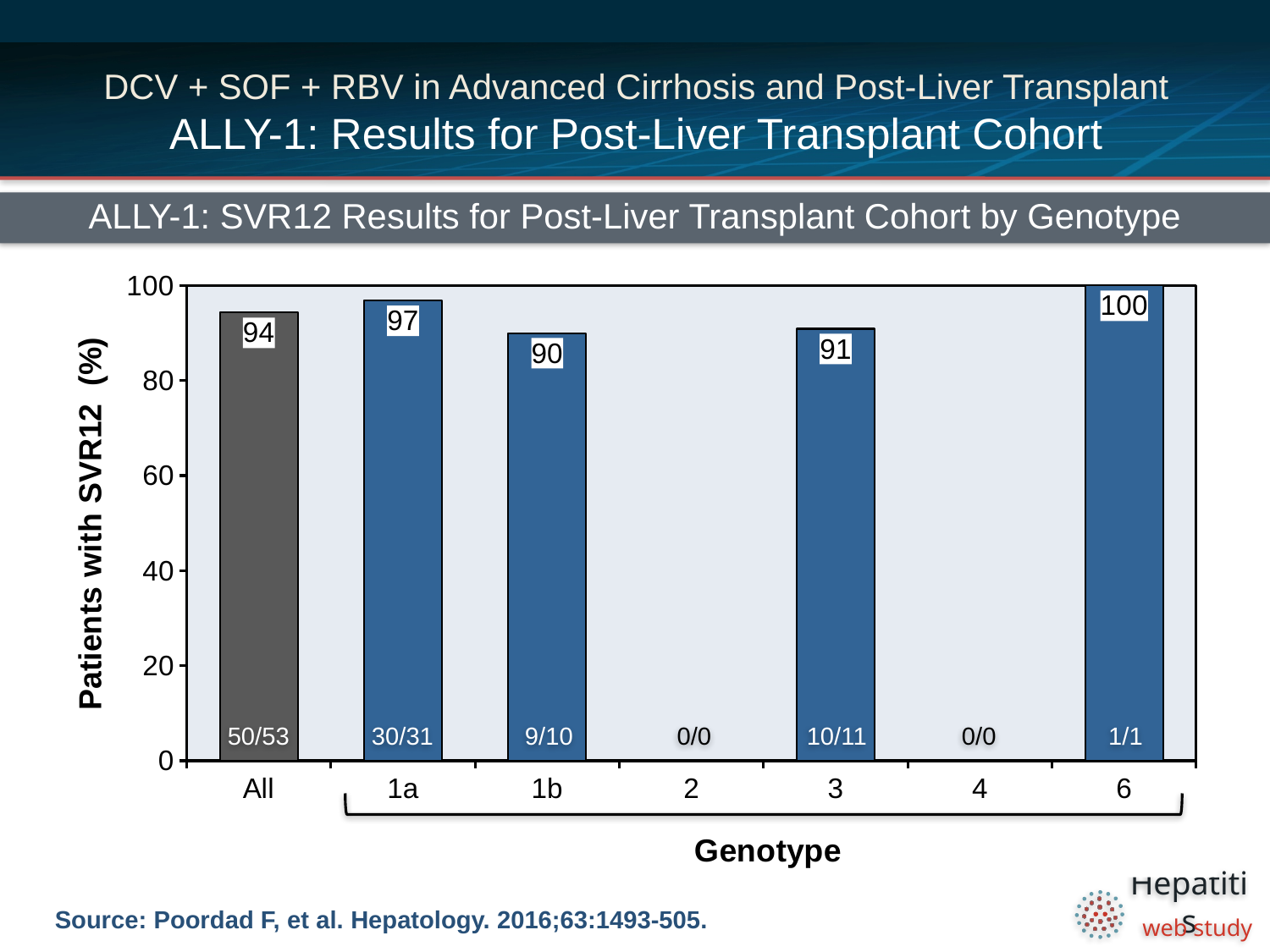
What is the SVR12 rate for genotype 3? 91 What is the SVR12 rate for genotype 1a? 97 What is the SVR12 rate for genotype 6? 100 What is the SVR12 rate for the All group? 94 Which genotype has the highest SVR12 rate? 6 What is the SVR12 rate for genotype 1b? 90 How many patients achieved SVR12 in the All group, as shown at the base of the bar? 50/53 What is the difference in SVR12 rate between genotype 1a and genotype 1b? 7 What kind of chart is shown on the slide? Bar chart How many genotype categories are labelled on the x axis, including All? 7 What is the patient fraction shown for genotype 1a? 30/31 Which has a higher SVR12 rate, genotype 1a or genotype 3? 1a